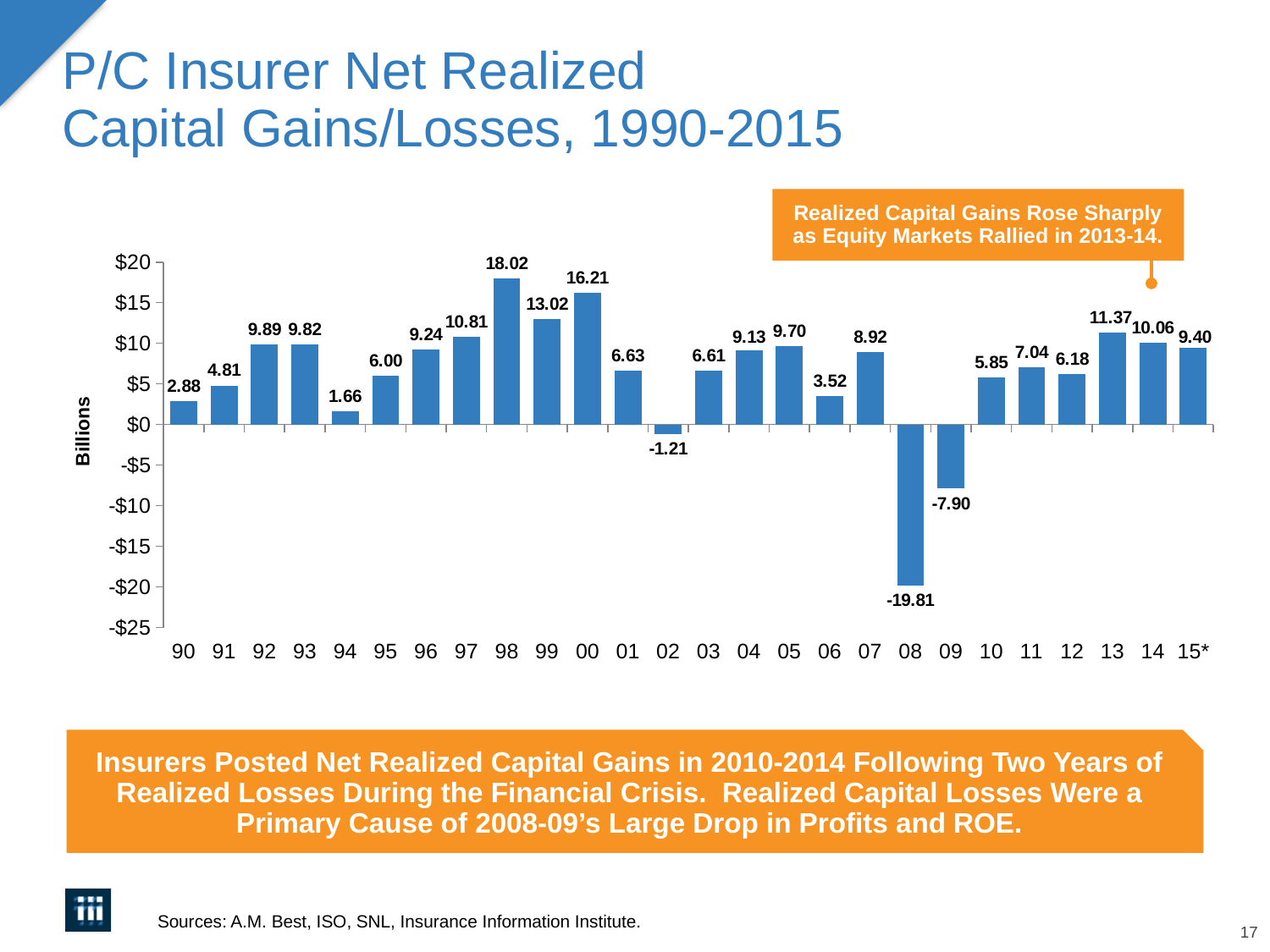
Do the values rise or fall from 2013 (13) to 2015 (15*)? Fall What is the difference between the values for 2013 (13) and 2012 (12)? 5.19 What value is shown for 2015 (15*)? 9.40 What was the net realized capital gain in 1998 (98)? 18.02 Which year has the lowest value on the chart? 08 Which year has the highest net realized capital gain? 98 What type of chart is shown on the slide? Bar chart What is the difference between the values for 1998 (98) and 1999 (99)? 5.00 Which year has the larger value, 2000 (00) or 1999 (99)? 00 What value is shown for 2008 (08)? -19.81 How many years show a negative value (net realized capital loss)? 3 How many years (bars) are plotted on the chart? 26